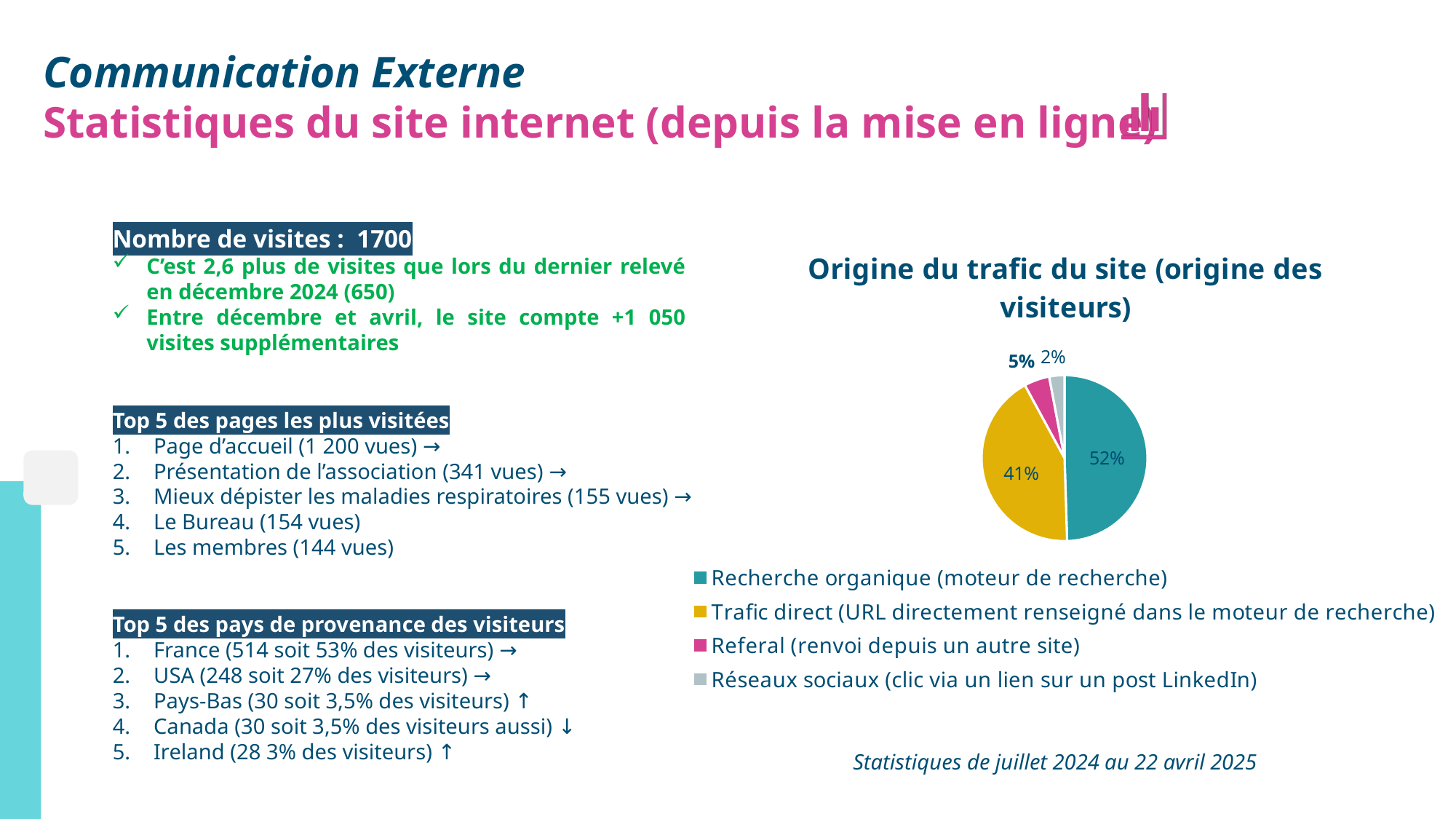
What is the title of the chart? Origine du trafic du site (origine des visiteurs) What is the difference in percentage points between Recherche organique and Trafic direct? 11 Which traffic source has the smallest slice of the pie? Réseaux sociaux (clic via un lien sur un post LinkedIn) What kind of chart is shown on the slide? pie chart What colour is the slice for Trafic direct? yellow How many categories does the legend of the pie chart list? 4 What share of the pie does Trafic direct (URL directement renseigné dans le moteur de recherche) represent? 41% Which traffic source has the largest slice of the pie? Recherche organique (moteur de recherche) What share of the pie does Referal (renvoi depuis un autre site) represent? 5% What share of the pie does Réseaux sociaux (clic via un lien sur un post LinkedIn) represent? 2% Which is larger, the share for Referal or the share for Réseaux sociaux? Referal (renvoi depuis un autre site)